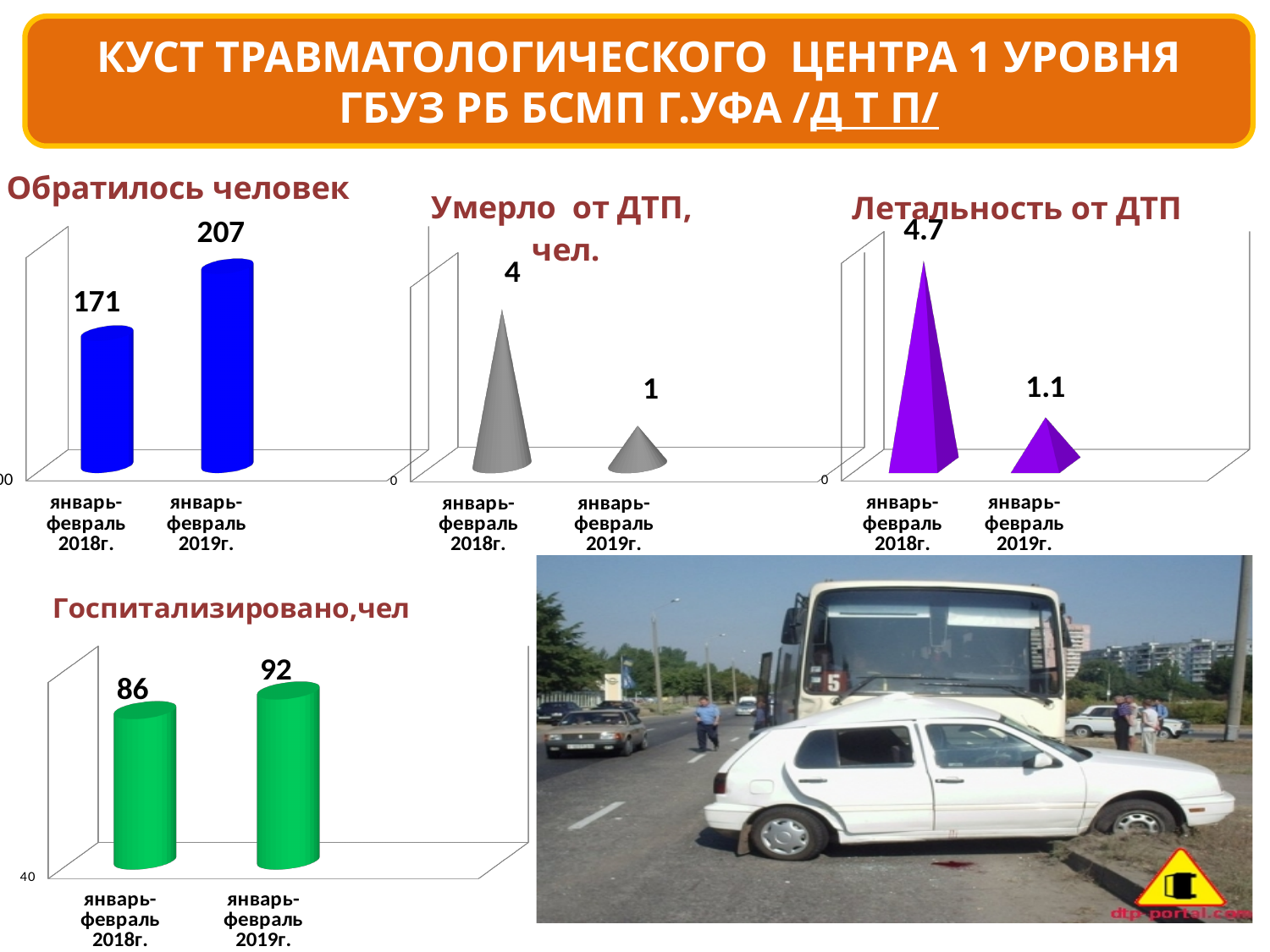
In the chart titled "Летальность от ДТП", what is the value for январь-февраль 2019г.? 1.1 In the chart titled "Обратилось человек", what is the value for январь-февраль 2018г.? 171 In the chart titled "Умерло от ДТП, чел.", which period has the lowest value? январь-февраль 2019г. In the chart titled "Госпитализировано,чел", which period has the higher value, январь-февраль 2018г. or январь-февраль 2019г.? январь-февраль 2019г. In the chart titled "Летальность от ДТП", do the values rise or fall from 2018 to 2019? fall In the chart titled "Обратилось человек", what is the value for январь-февраль 2019г.? 207 How many categories are shown in the chart titled "Госпитализировано,чел"? 2 In the chart titled "Летальность от ДТП", what is the value for январь-февраль 2018г.? 4.7 What kind of chart is the chart titled "Обратилось человек"? bar chart In the chart titled "Госпитализировано,чел", what is the value for январь-февраль 2019г.? 92 In the chart titled "Умерло от ДТП, чел.", what is the value for январь-февраль 2018г.? 4 In the chart titled "Обратилось человек", what is the difference between the 2019 and 2018 values? 36